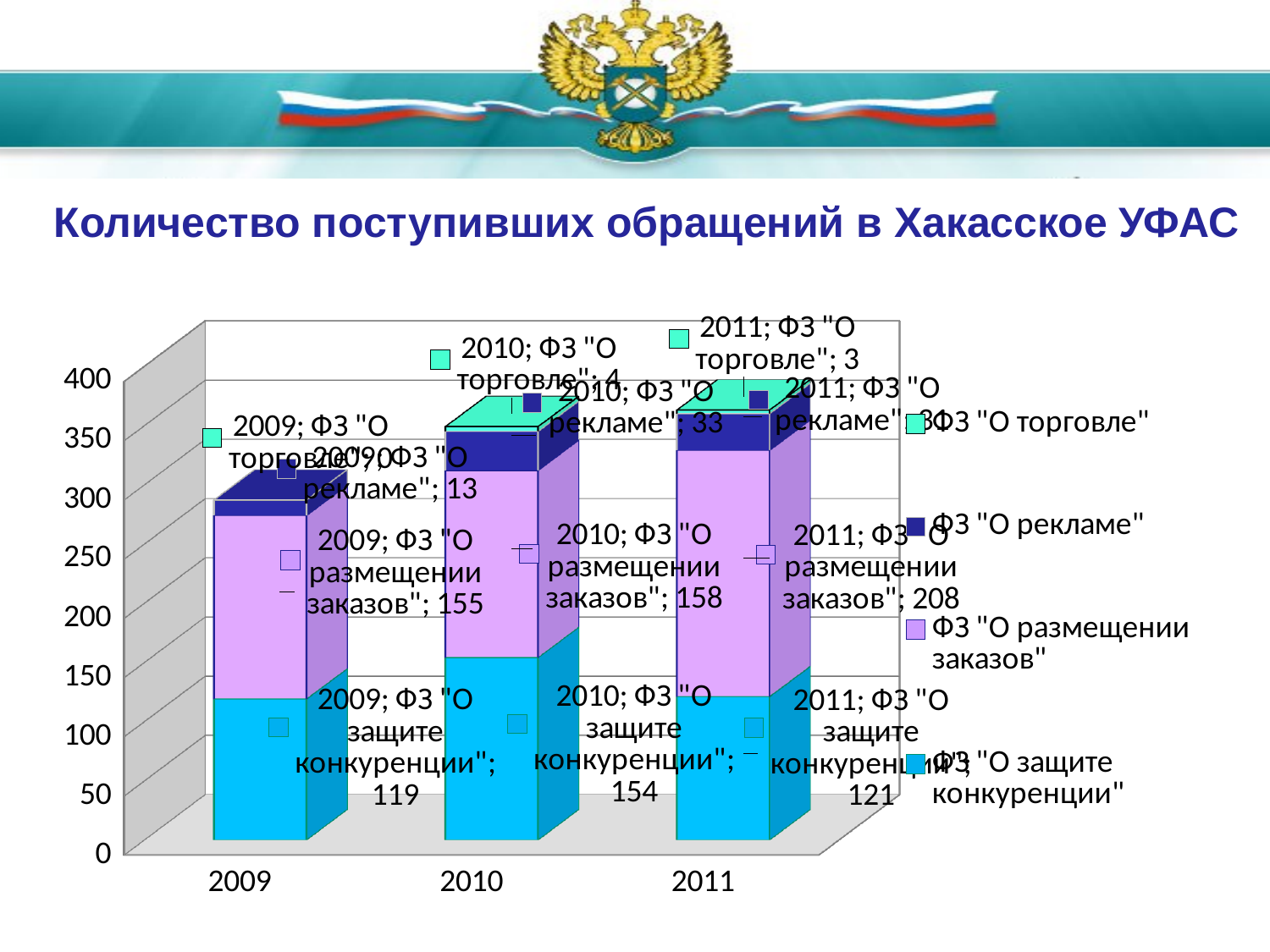
In which year is the value for ФЗ "О размещении заказов" the highest? 2011 What kind of chart is shown on the slide? Stacked bar chart What is the value for ФЗ "О рекламе" in 2010? 33 What is the value for ФЗ "О защите конкуренции" in 2009? 119 How many series does the chart legend list? 4 What is the value for ФЗ "О торговле" in 2010? 4 What is the value for ФЗ "О торговле" in 2009? 0 What is the difference between the ФЗ "О защите конкуренции" values for 2010 and 2009? 35 What is the total of the stacked bar for 2009? 287 In which year is the value for ФЗ "О защите конкуренции" the highest? 2010 How many years are shown on the x axis of the chart? 3 What is the value for ФЗ "О размещении заказов" in 2011? 208